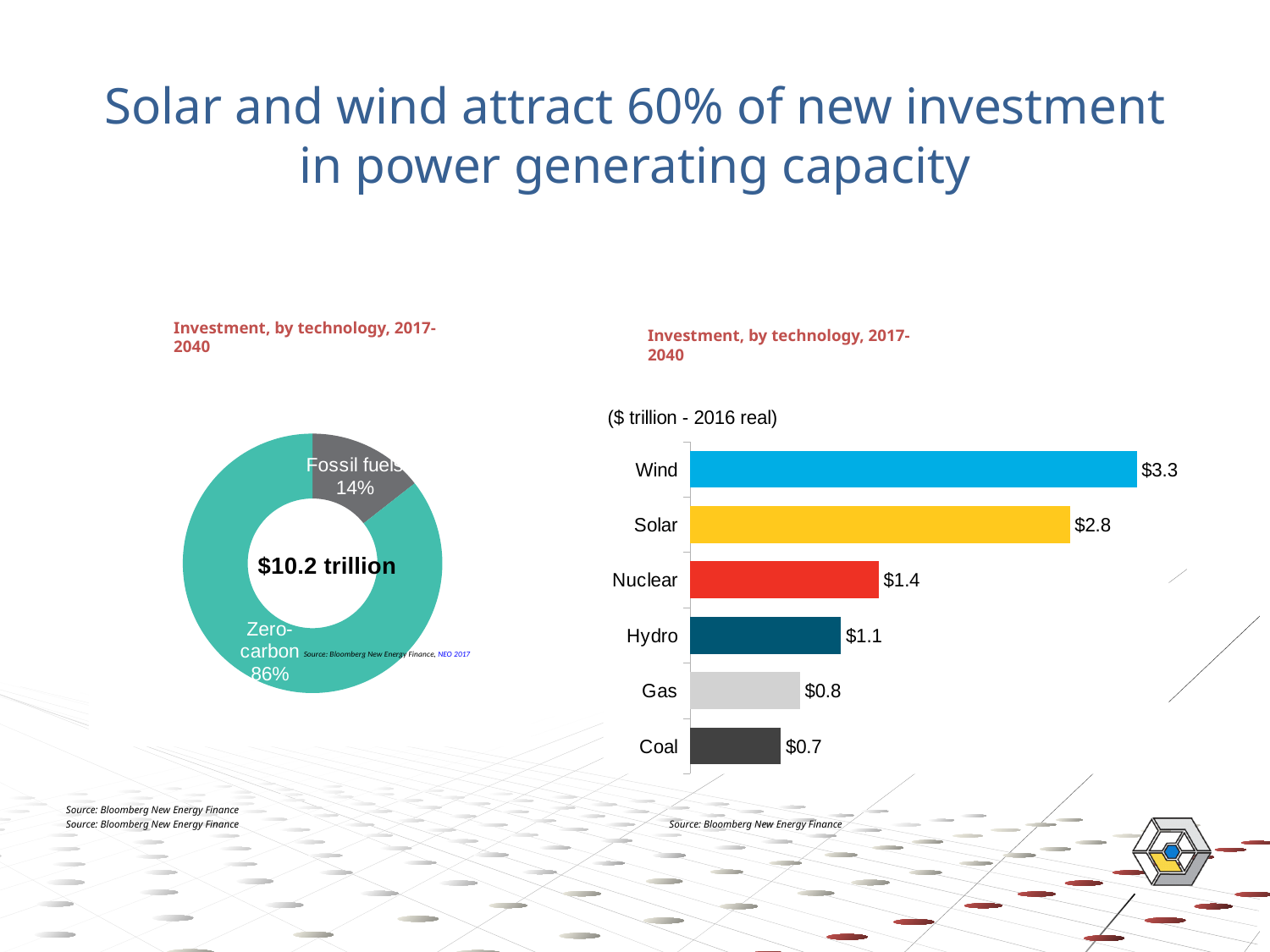
In the donut chart on the left, what share of investment goes to Fossil fuels? 14% In the bar chart on the right, which is larger, the value for Hydro or the value for Gas? Hydro In the bar chart on the right, what is the value for Wind? $3.3 In the bar chart on the right, which technology has the lowest investment? Coal In the bar chart on the right, what is the difference between the values for Wind and Solar? $0.5 In the bar chart on the right, which technology has the highest investment? Wind In the donut chart on the left, what share of investment goes to Zero-carbon? 86% In the bar chart on the right, what is the value for Nuclear? $1.4 What unit is stated above the bar chart on the right? $ trillion - 2016 real What kind of chart is the chart on the right of the slide? Bar chart What total value is shown in the centre of the donut chart on the left? $10.2 trillion How many technologies are shown in the bar chart on the right? 6